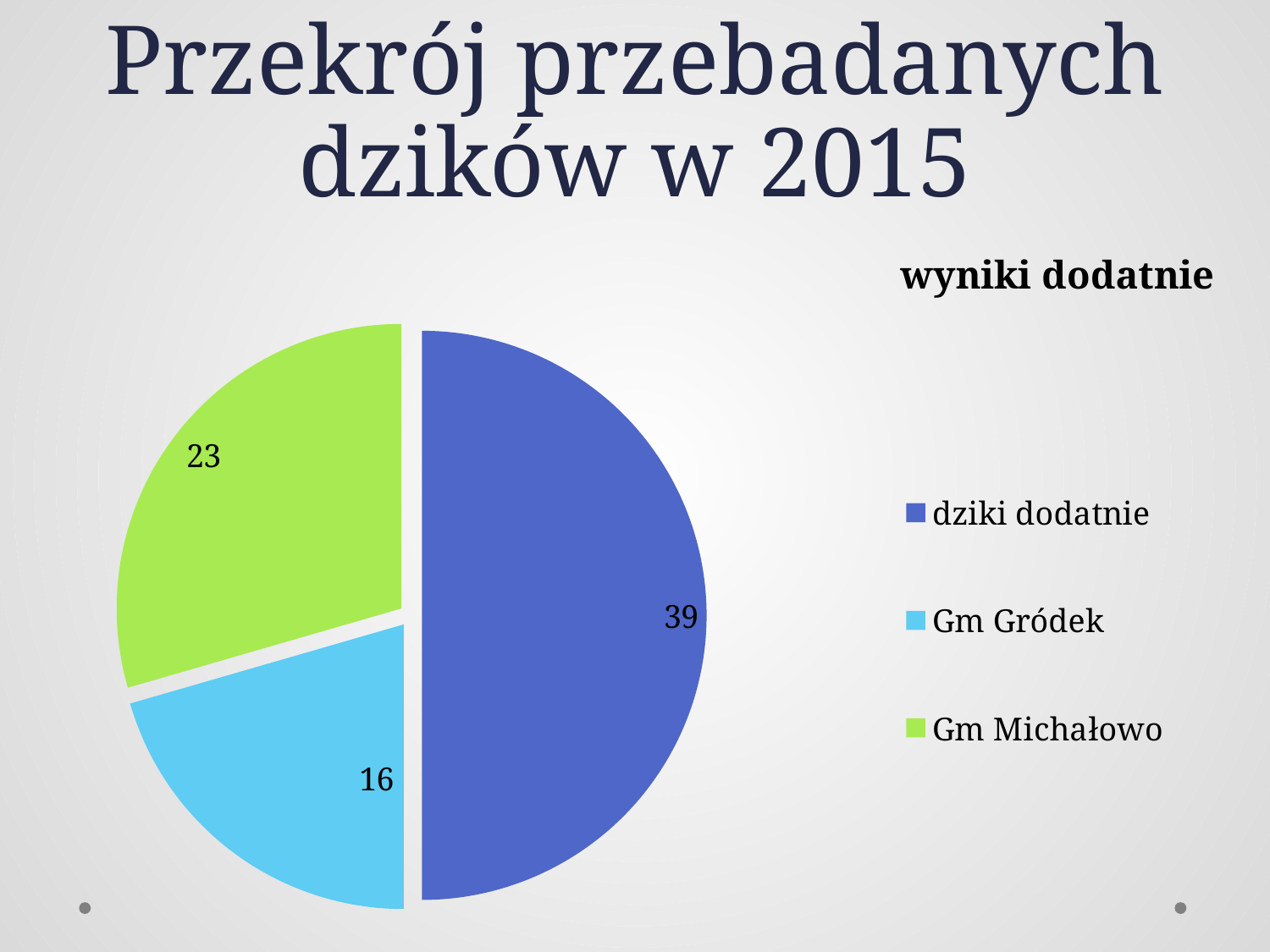
What share of the pie does dziki dodatnie represent? 50% What is the value for Gm Michałowo? 23 What is the value for dziki dodatnie? 39 How many slices does the pie chart have? 3 Which is larger, Gm Gródek or Gm Michałowo? Gm Michałowo What is the difference between the values for dziki dodatnie and Gm Michałowo? 16 Which category has the largest slice? dziki dodatnie What is the difference between the values for Gm Michałowo and Gm Gródek? 7 Which category has the smallest slice? Gm Gródek What type of chart is shown on the slide? pie chart What is the title of the chart? wyniki dodatnie What is the value for Gm Gródek? 16